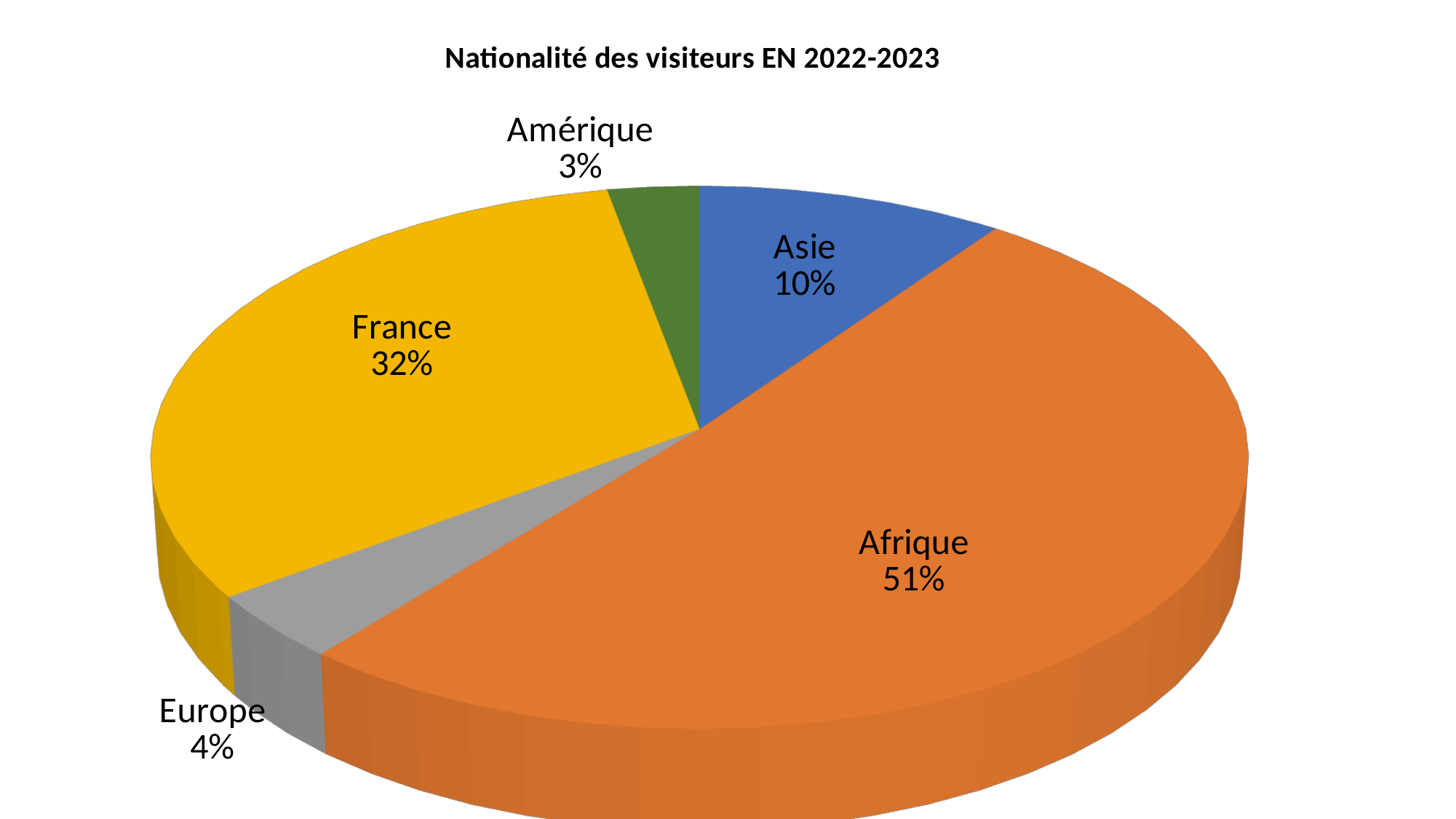
Which category has the smallest share of visitors? Amérique What type of chart is shown on the slide? Pie chart How many categories are shown in the pie chart? 5 What is the title of the chart? Nationalité des visiteurs EN 2022-2023 What percentage is shown for France? 32% What percentage is shown for Amérique? 3% What percentage is shown for Europe? 4% What share of visitors does the Afrique slice represent? 51% What percentage is shown for Asie? 10% Which category has the largest share of visitors? Afrique Which has a larger share, Asie or Europe? Asie What is the difference in percentage points between Afrique and France? 19